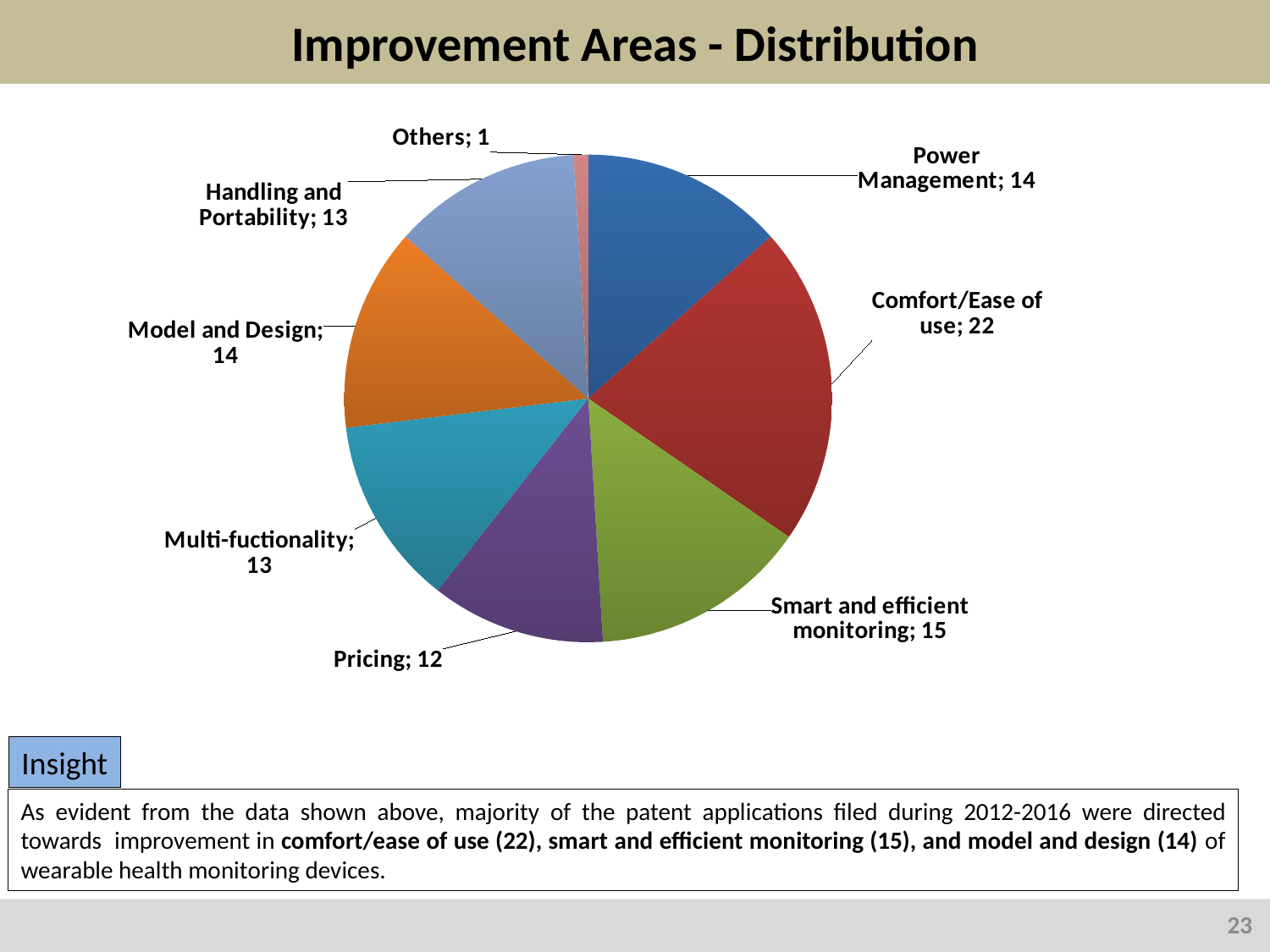
What is the value for Pricing? 12 What is the title of the slide containing the chart? Improvement Areas - Distribution What is the value for Smart and efficient monitoring? 15 Which category has the largest slice of the pie? Comfort/Ease of use How many categories are shown in the pie chart? 8 What type of chart is shown on the slide? Pie chart What is the value for Comfort/Ease of use? 22 Which is larger, the value for Power Management or the value for Pricing? Power Management What is the total of all the values shown in the pie chart? 104 Which category has the smallest slice of the pie? Others What is the difference between the values for Comfort/Ease of use and Smart and efficient monitoring? 7 What is the value for Handling and Portability? 13